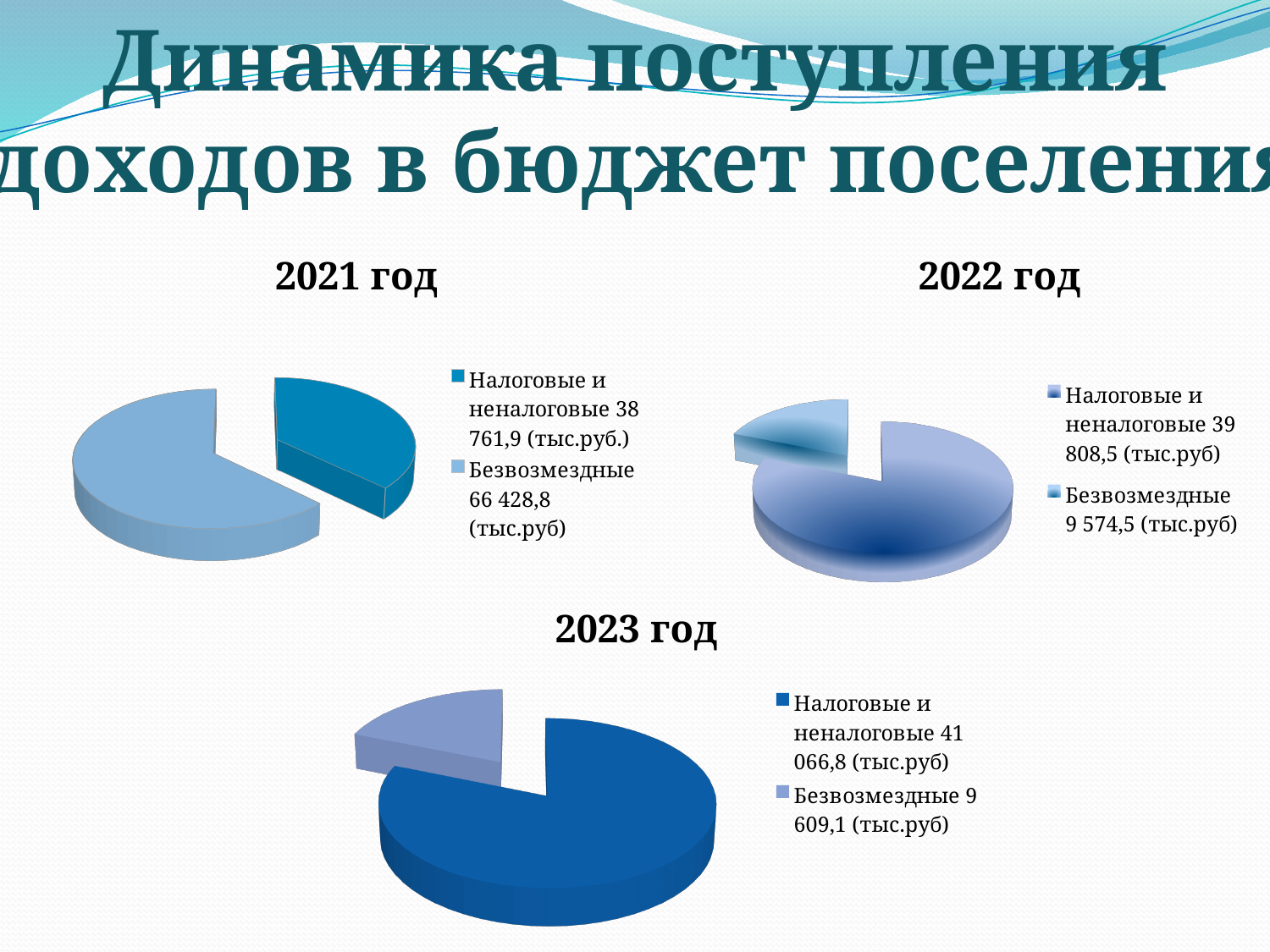
What type of chart is used for 2021 год? Pie chart On the 2023 год chart, what is the total of the two categories? 50 675,9 (тыс.руб) On the 2023 год chart, which category is the smallest? Безвозмездные On the 2021 год chart, what is the value for Налоговые и неналоговые? 38 761,9 (тыс.руб.) On the 2021 год chart, what is the difference between Безвозмездные and Налоговые и неналоговые? 27 666,9 (тыс.руб) How many categories does the 2022 год chart show? 2 On the 2023 год chart, what is the value for Налоговые и неналоговые? 41 066,8 (тыс.руб) On the 2022 год chart, what is the value for Безвозмездные? 9 574,5 (тыс.руб) On the 2021 год chart, what is the value for Безвозмездные? 66 428,8 (тыс.руб) On the 2021 год chart, which category is the largest? Безвозмездные On the 2022 год chart, which is larger: Налоговые и неналоговые or Безвозмездные? Налоговые и неналоговые